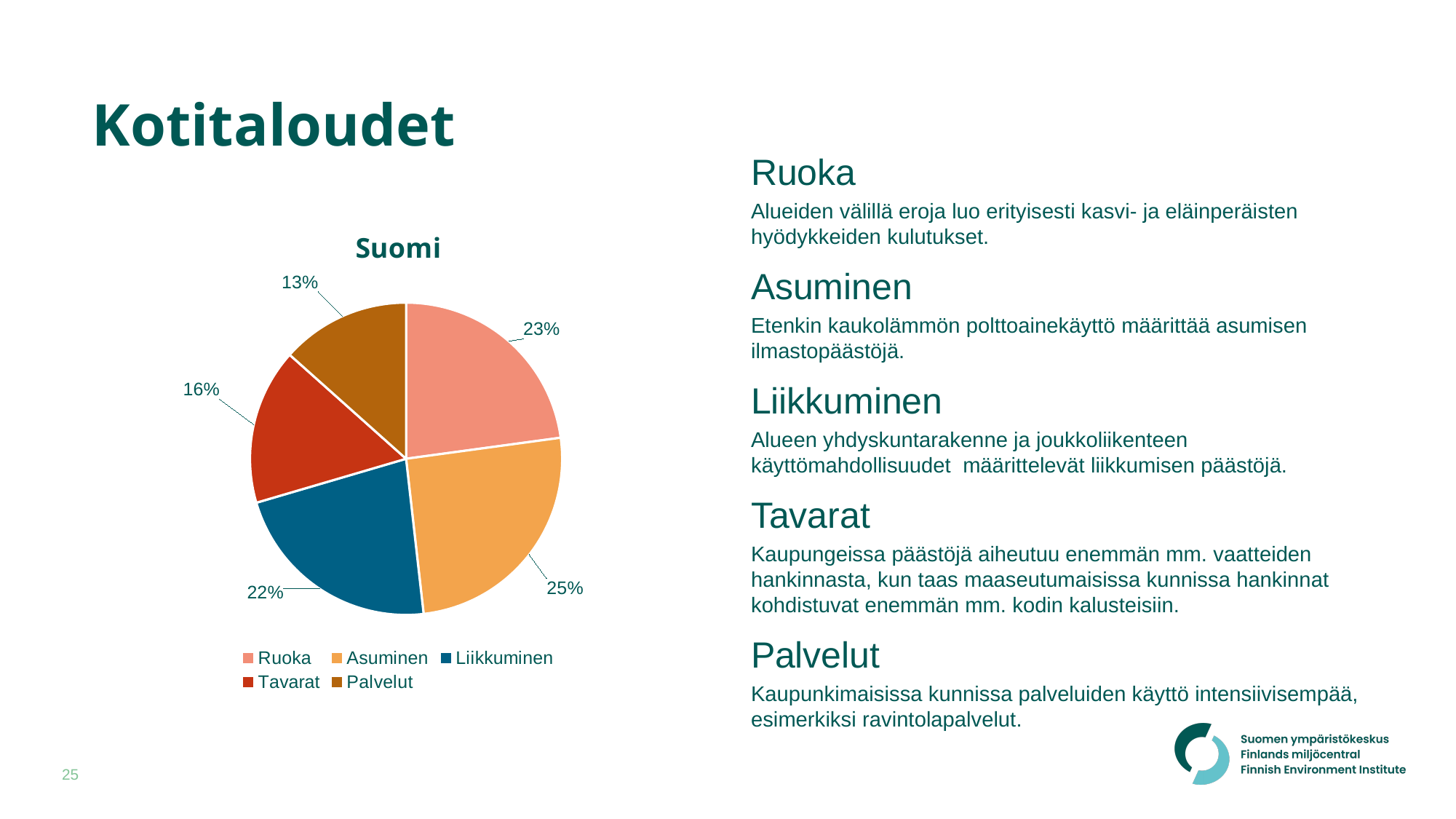
Which category has the largest slice of the pie? Asuminen What share of the pie does Liikkuminen have? 22% What is the title of the pie chart? Suomi What share of the pie does Ruoka have? 23% Which category has the smallest slice of the pie? Palvelut What share of the pie does Palvelut have? 13% What share of the pie does Asuminen have? 25% Which is larger, the share for Tavarat or the share for Liikkuminen? Liikkuminen How many categories does the pie chart legend list? 5 What kind of chart is shown on the slide? Pie chart What share of the pie does Tavarat have? 16% What is the difference in percentage points between Asuminen and Palvelut? 12